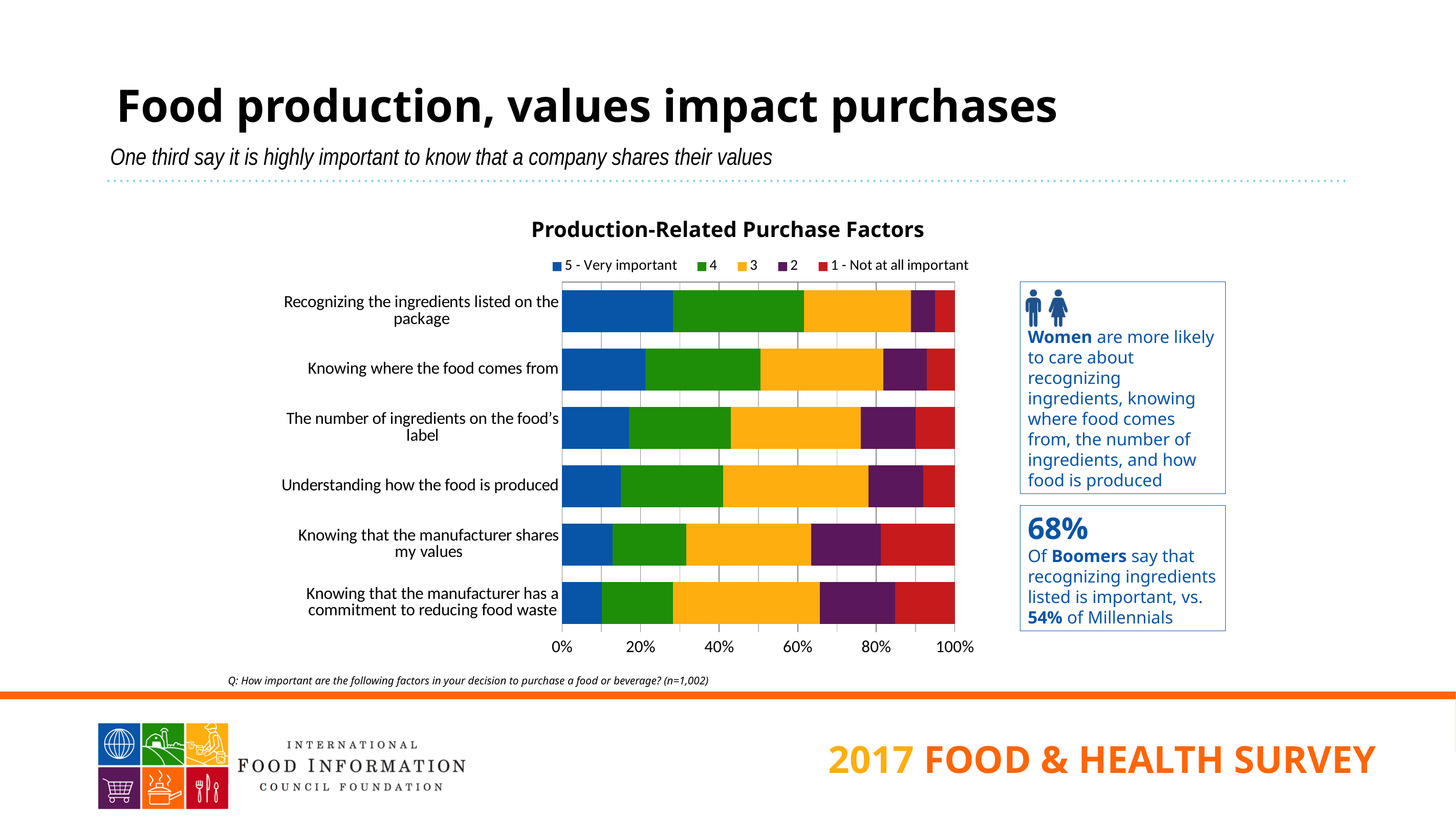
Which has a larger '5 - Very important' segment: 'Recognizing the ingredients listed on the package' or 'Knowing where the food comes from'? Recognizing the ingredients listed on the package Is the '5 - Very important' value for 'Knowing that the manufacturer has a commitment to reducing food waste' greater or less than 20%? less Which purchase factor has the smallest '5 - Very important' segment? Knowing that the manufacturer has a commitment to reducing food waste Which has a larger '1 - Not at all important' segment: 'Recognizing the ingredients listed on the package' or 'Knowing that the manufacturer shares my values'? Knowing that the manufacturer shares my values Which legend entry is shown in blue? 5 - Very important Which purchase factor has the largest '5 - Very important' segment? Recognizing the ingredients listed on the package What type of chart is shown on the slide? Stacked bar chart What is the title of the chart? Production-Related Purchase Factors Is the '5 - Very important' value for 'Recognizing the ingredients listed on the package' greater or less than 20%? greater How many series does the chart legend list? 5 How many purchase factors (categories) are plotted in the chart? 6 Moving from the top category to the bottom category, does the '5 - Very important' segment get larger or smaller? Smaller